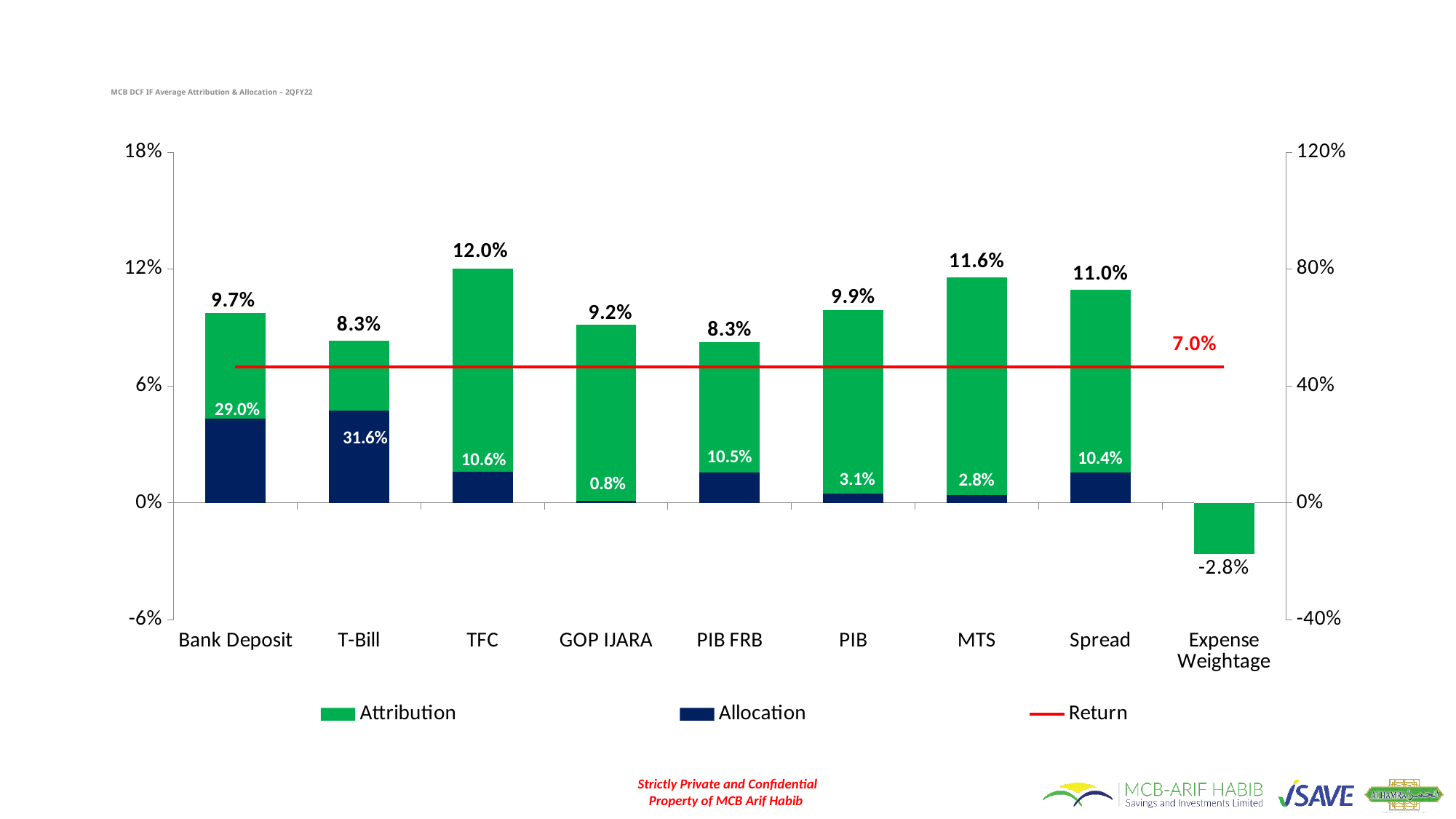
Which category has the highest Allocation value? T-Bill What value is shown for the Return line? 7.0% Which category has the highest Attribution value? TFC What is the Attribution value for TFC? 12.0% What is the difference between the Attribution values for TFC and MTS? 0.4% How many series does the legend list? 3 Which has a larger Attribution value, Bank Deposit or T-Bill? Bank Deposit What is the Attribution value for Expense Weightage? -2.8% Which category has the lowest Allocation value? GOP IJARA What is the Allocation value for T-Bill? 31.6% What colour represents the Allocation series? Dark blue How many categories are shown on the x axis? 9